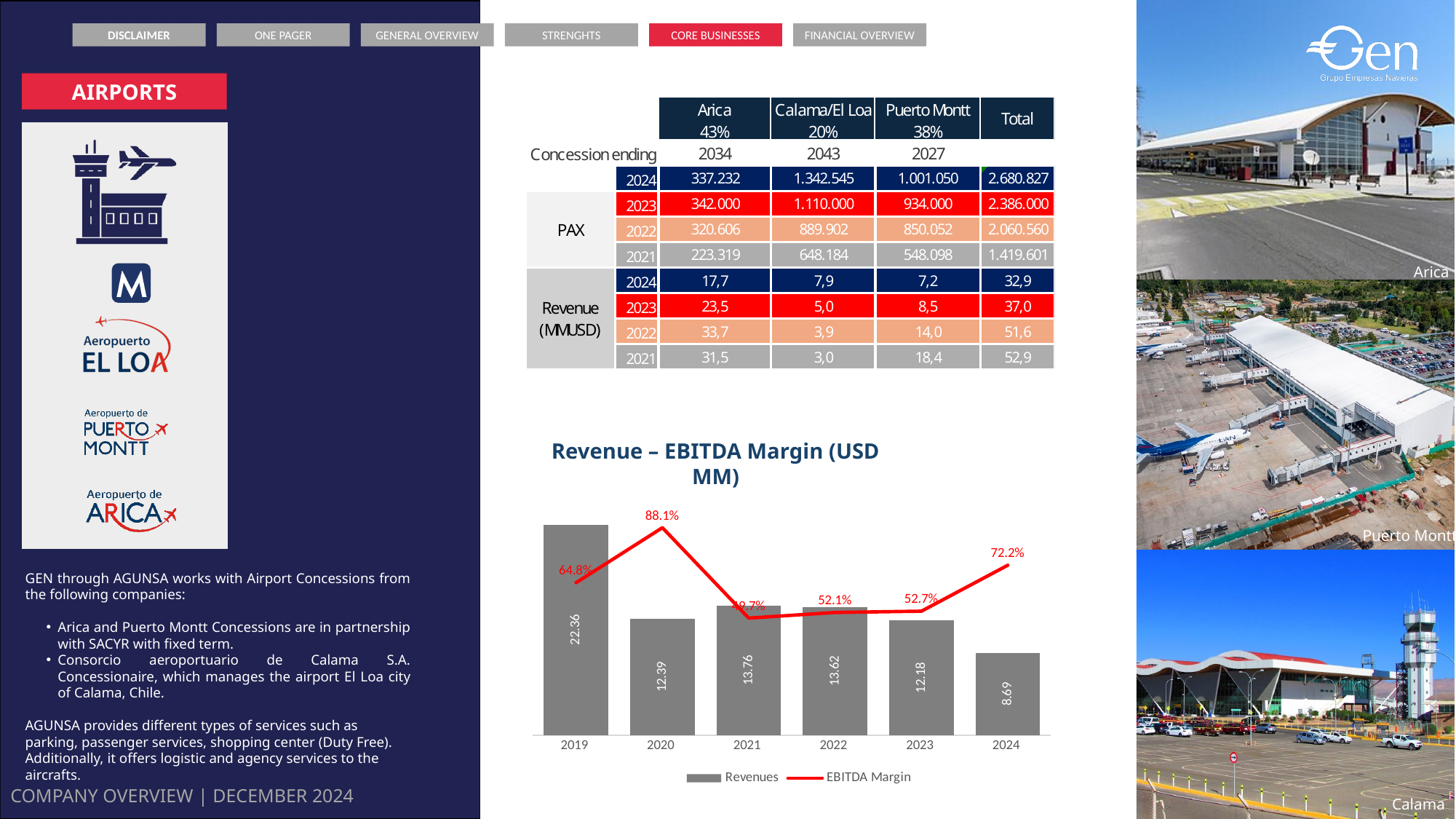
In the Revenue – EBITDA Margin chart, which year has the highest EBITDA Margin? 2020 In the Revenue – EBITDA Margin chart, what is the EBITDA Margin for 2024? 72.2% What series are listed in the legend of the Revenue – EBITDA Margin chart? Revenues and EBITDA Margin In the Revenue – EBITDA Margin chart, what is the Revenues value for 2019? 22.36 In the Revenue – EBITDA Margin chart, which year has the lowest Revenues? 2024 In the Revenue – EBITDA Margin chart, is the Revenues value for 2021 or 2023 larger? 2021 How many years are shown on the x axis of the Revenue – EBITDA Margin chart? 6 How many series does the legend of the Revenue – EBITDA Margin chart list? 2 In the Revenue – EBITDA Margin chart, what is the EBITDA Margin for 2020? 88.1% In the Revenue – EBITDA Margin chart, what is the Revenues value for 2024? 8.69 In the Revenue – EBITDA Margin chart, which year has the highest Revenues? 2019 In the Revenue – EBITDA Margin chart, what is the difference in Revenues between 2019 and 2020? 9.97